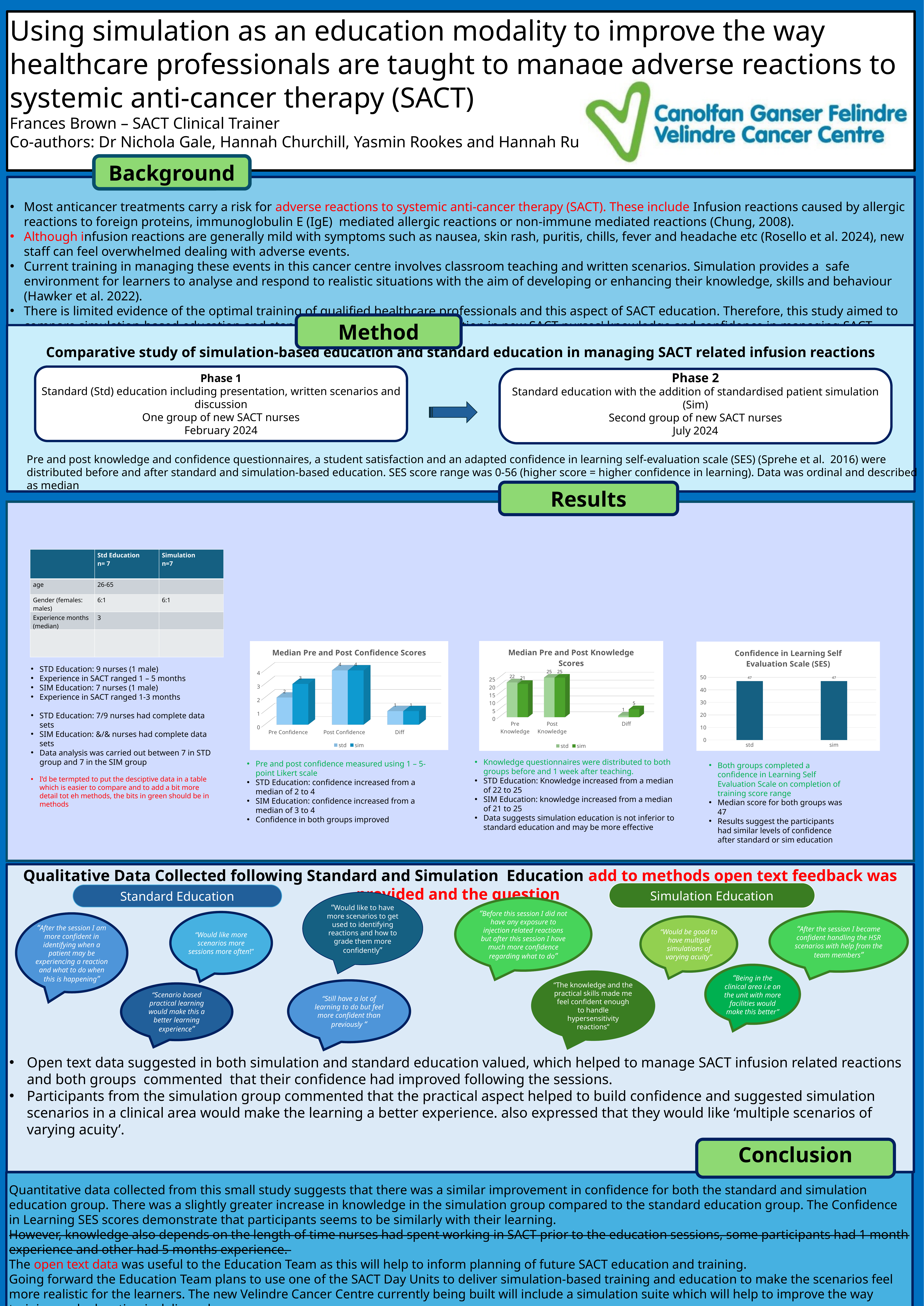
In the 'Median Pre and Post Confidence Scores' chart, how many series does the legend list? 2 In the 'Median Pre and Post Knowledge Scores' chart, how many categories are shown on the x axis? 3 In the 'Median Pre and Post Confidence Scores' chart, what is the Post Confidence value for std? 4 In the 'Median Pre and Post Knowledge Scores' chart, what is the difference between the Diff values for sim and std? 4 In the 'Median Pre and Post Knowledge Scores' chart, what is the Pre Knowledge value for sim? 21 In the 'Median Pre and Post Confidence Scores' chart, what is the Pre Confidence value for std? 2 In the 'Confidence in Learning Self Evaluation Scale (SES)' chart, is the value for sim greater or less than 40? greater In the 'Median Pre and Post Confidence Scores' chart, what is the Pre Confidence value for sim? 3 What kind of chart is the 'Confidence in Learning Self Evaluation Scale (SES)' chart? bar chart In the 'Median Pre and Post Knowledge Scores' chart, what is the Diff value for sim? 5 In the 'Median Pre and Post Knowledge Scores' chart, which series has the larger Pre Knowledge value, std or sim? std In the 'Confidence in Learning Self Evaluation Scale (SES)' chart, what is the value for std? 47